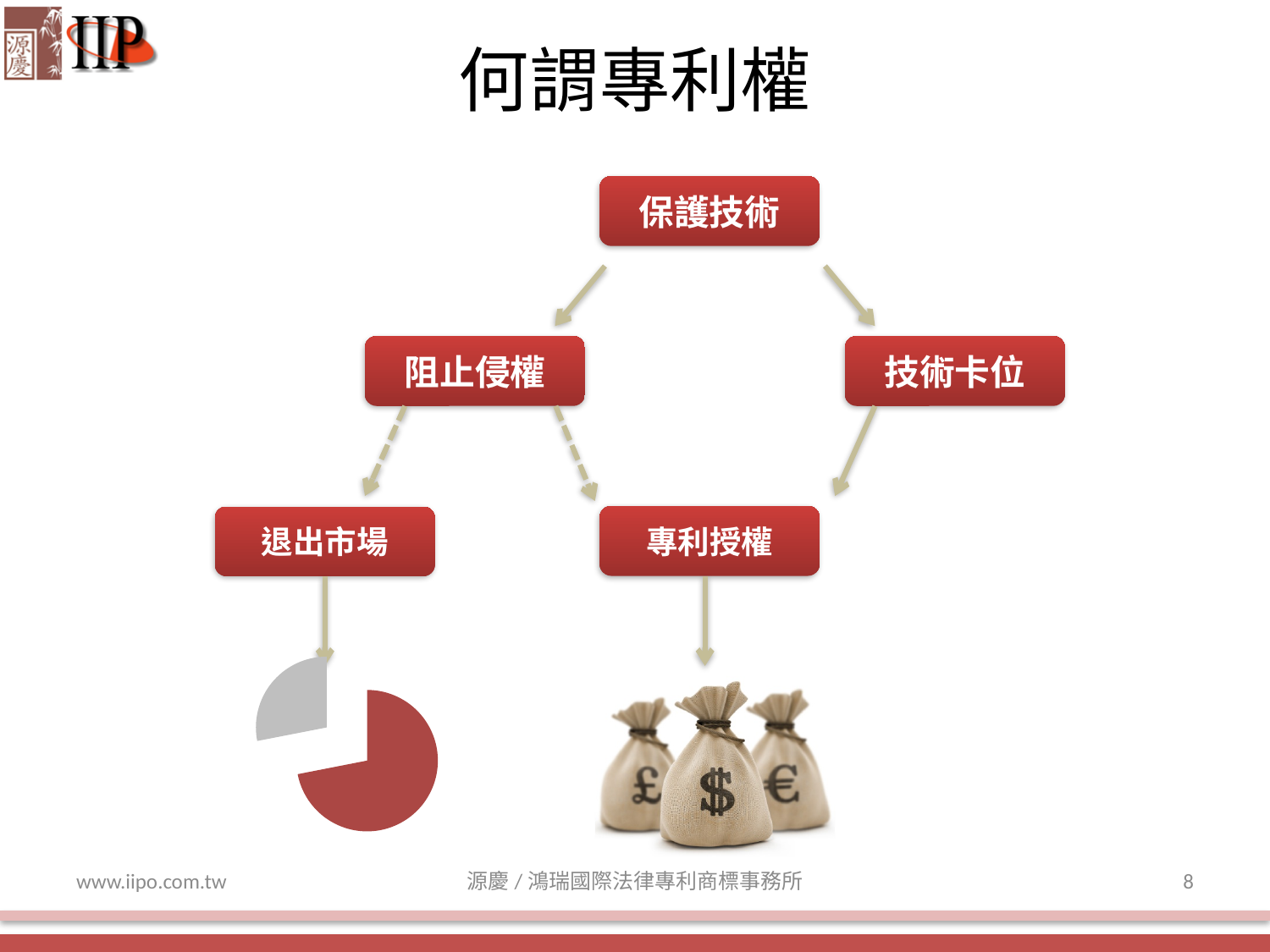
Which box in the flowchart does the arrow pointing to the pie chart come from? 退出市場 How many slices does the pie chart at the bottom left of the slide have? 2 In the pie chart at the bottom left of the slide, which slice is pulled out from the rest of the pie? the grey slice In the pie chart at the bottom left of the slide, which slice is larger, the red one or the grey one? red What kind of chart is shown at the bottom left of the slide, below the 退出市場 box? pie chart